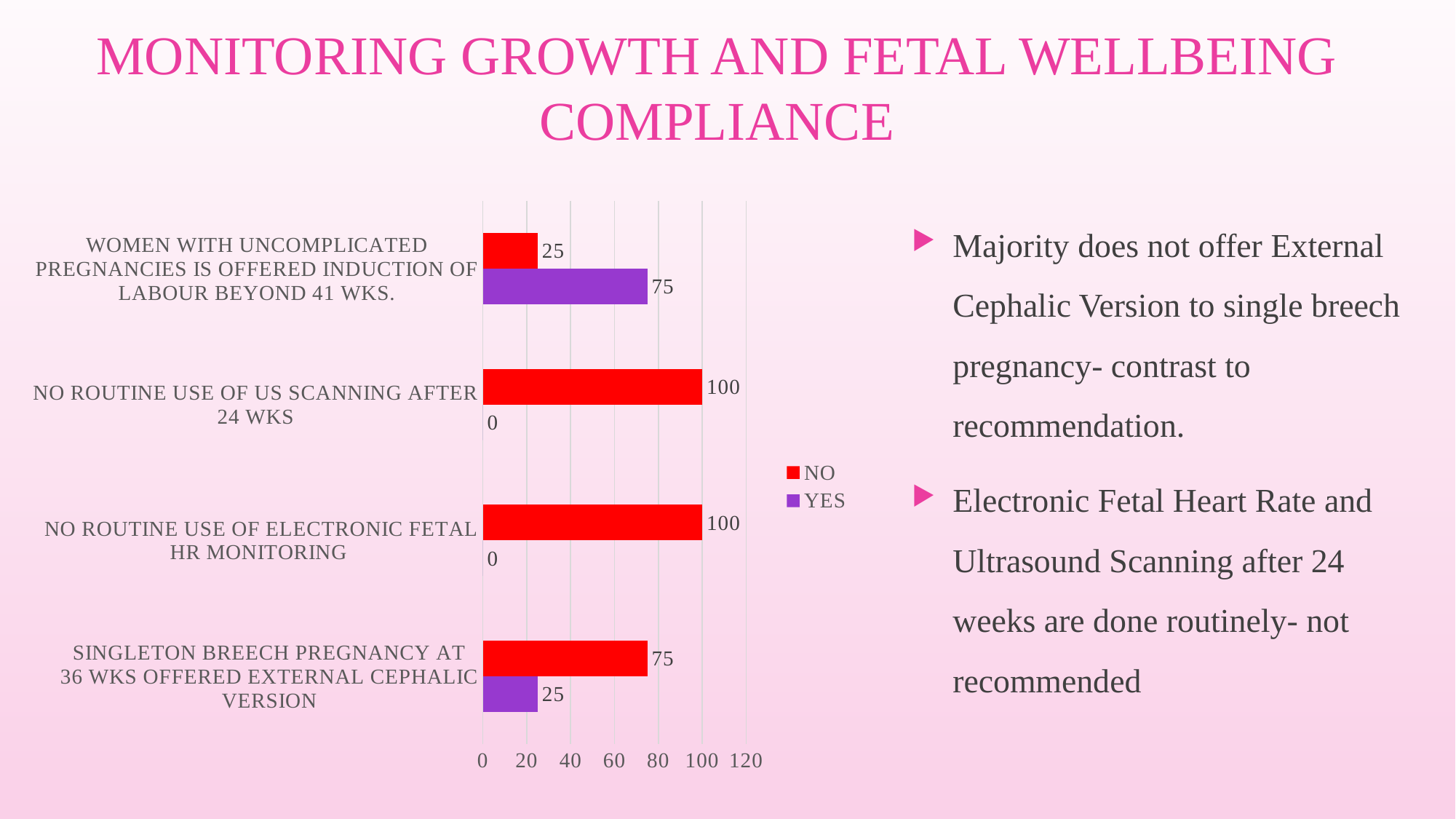
Which category has the highest YES value? Women with uncomplicated pregnancies is offered induction of labour beyond 41 wks. How many series does the legend list? 2 For 'Women with uncomplicated pregnancies is offered induction of labour beyond 41 wks.', which is larger, the NO value or the YES value? YES What kind of chart is shown on the slide? Bar chart What is the YES value for 'No routine use of electronic fetal HR monitoring'? 0 How many categories are shown on the chart? 4 What is the NO value for 'Women with uncomplicated pregnancies is offered induction of labour beyond 41 wks.'? 25 What is the YES value for 'Women with uncomplicated pregnancies is offered induction of labour beyond 41 wks.'? 75 What is the NO value for 'No routine use of US scanning after 24 wks'? 100 What is the difference between the NO and YES values for 'Singleton breech pregnancy at 36 wks offered external cephalic version'? 50 Which category has the lowest NO value? Women with uncomplicated pregnancies is offered induction of labour beyond 41 wks. What is the YES value for 'Singleton breech pregnancy at 36 wks offered external cephalic version'? 25